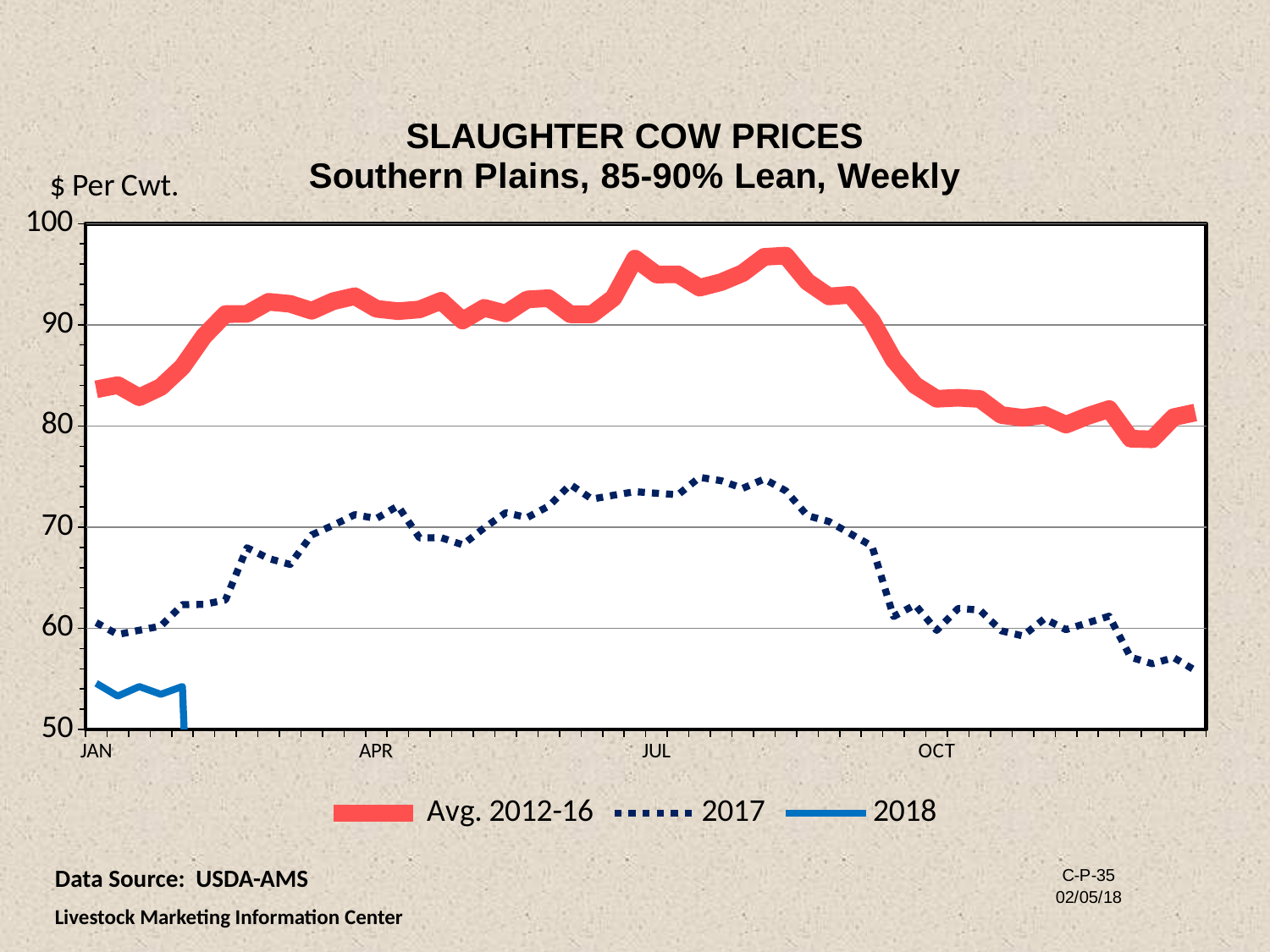
What kind of chart is shown on the slide? line chart Which series is lower in JAN, 2017 or 2018? 2018 Is the 2017 value around JUL greater or less than 70? greater Does the 2017 series rise or fall from OCT to the end of the year? fall What unit is shown on the y axis label? $ Per Cwt. Is the Avg. 2012-16 value in early JAN greater or less than 80? greater Is the 2017 value in early JAN greater or less than 70? less Which series is higher around JUL, Avg. 2012-16 or 2017? Avg. 2012-16 How many series does the legend list? 3 What is the title of the chart? SLAUGHTER COW PRICES Southern Plains, 85-90% Lean, Weekly